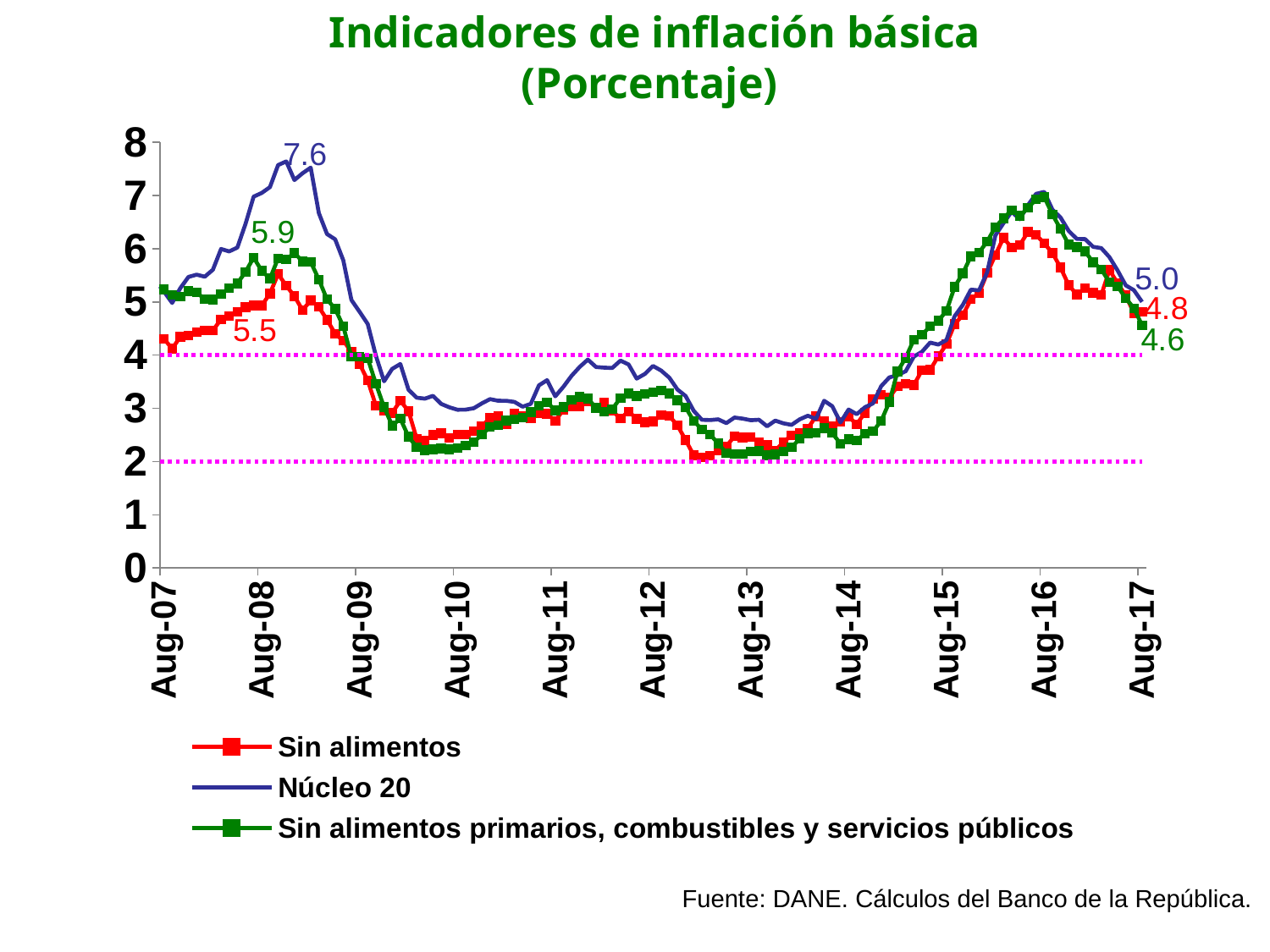
Do the series rise or fall between Aug-16 and Aug-17? fall What is the value of Sin alimentos primarios, combustibles y servicios públicos at Aug-17? 4.6 What is the value of Sin alimentos at Aug-17? 4.8 What is the value of Núcleo 20 at Aug-17? 5.0 Which series has the highest value at Aug-17? Núcleo 20 At which two y-axis values are the dotted horizontal reference lines drawn? 2 and 4 How many series does the legend list? 3 Is the value of Sin alimentos at Aug-10 greater or less than 3? less What is the labelled peak value of Sin alimentos primarios, combustibles y servicios públicos in the 2008 period? 5.9 What type of chart is shown on the slide? line chart What is the difference between the Núcleo 20 value and the Sin alimentos primarios, combustibles y servicios públicos value at Aug-17? 0.4 What is the labelled peak value of Núcleo 20 in the 2008 period? 7.6